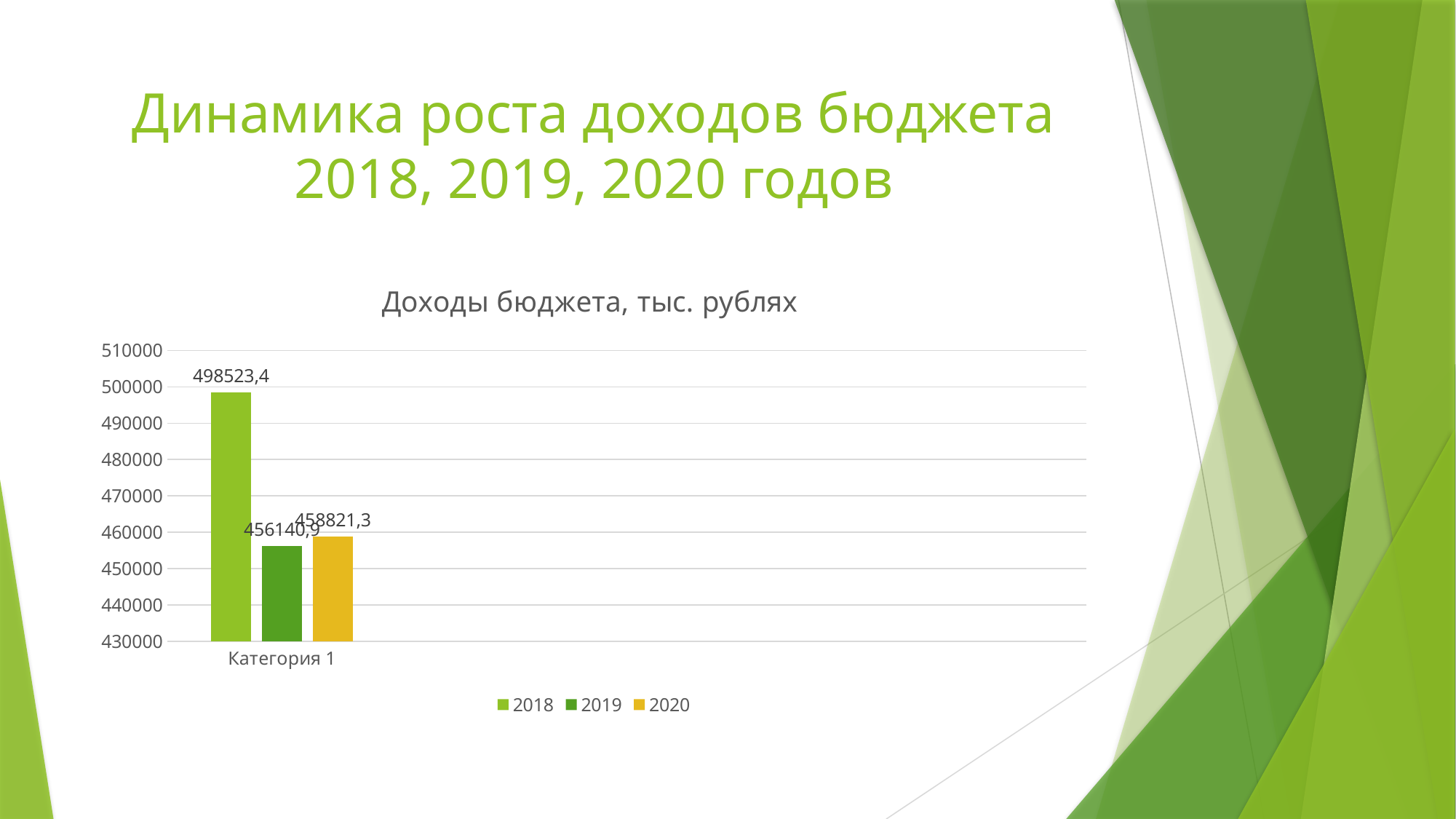
What is the value for 2020 in the chart? 458821,3 How many series does the legend list? 3 What is the difference between the 2020 value and the 2019 value? 2680,4 What is the difference between the 2018 value and the 2019 value? 42382,5 What kind of chart is shown on the slide? bar chart What is the value for 2019 in the chart? 456140,9 Which is larger, the value for 2018 or the value for 2020? 2018 What is the title of the chart? Доходы бюджета, тыс. рублях Which year has the highest value in the chart? 2018 Which year has the lowest value in the chart? 2019 What is the value for 2018 in the chart? 498523,4 Is the value for 2019 greater or less than 460000? less